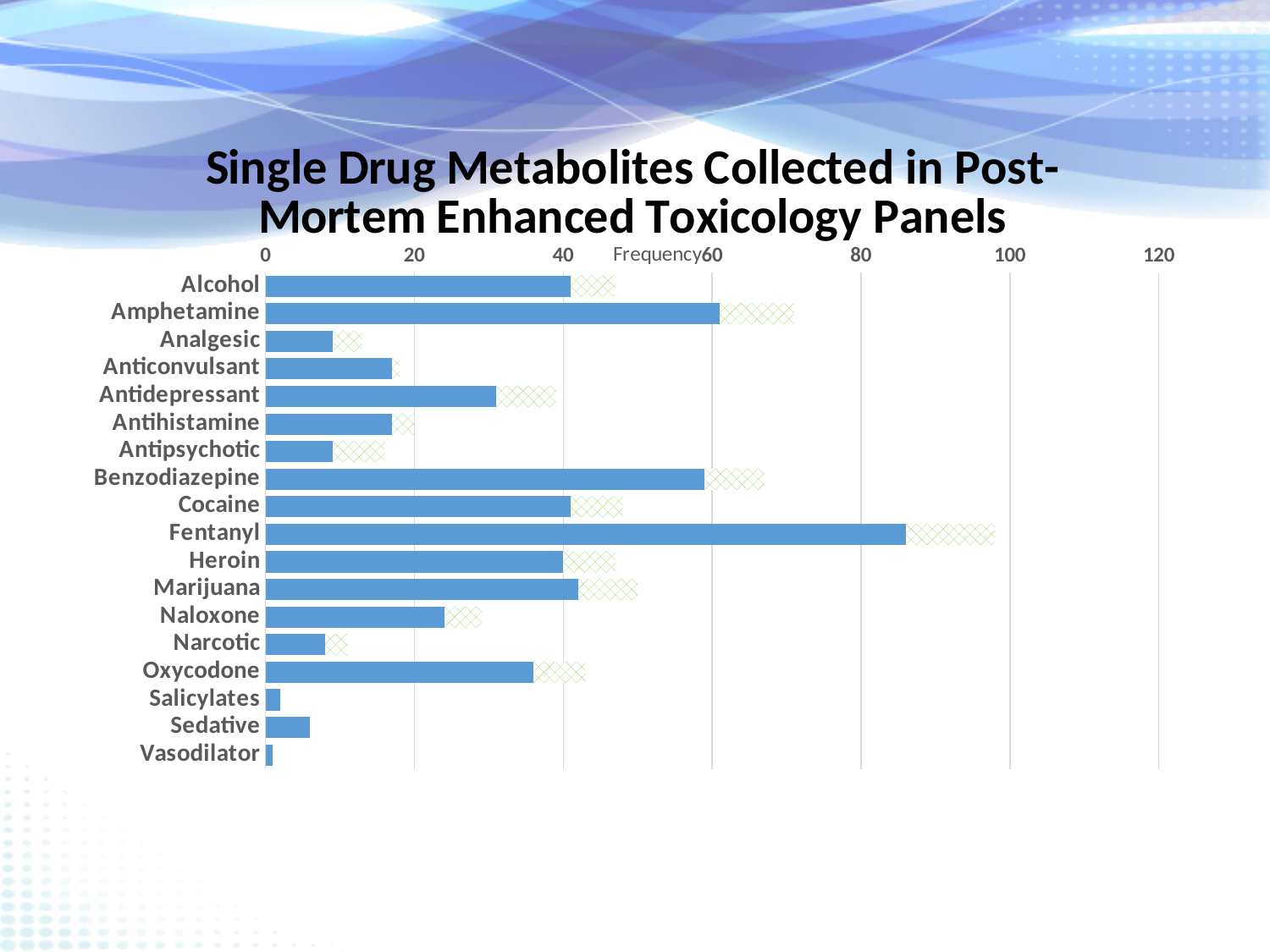
Which has a higher frequency, Fentanyl or Amphetamine? Fentanyl Which drug metabolite has the highest frequency? Fentanyl Which drug metabolite has the lowest frequency? Vasodilator Which has a higher frequency, Antidepressant or Naloxone? Antidepressant Is the value for Analgesic greater or less than 20? less How many drug metabolite categories are shown on the chart? 18 Is the value for Fentanyl greater or less than 80? greater What is the title of the chart? Single Drug Metabolites Collected in Post-Mortem Enhanced Toxicology Panels Is the value for Antidepressant greater or less than 20? greater What kind of chart is shown on the slide? bar chart